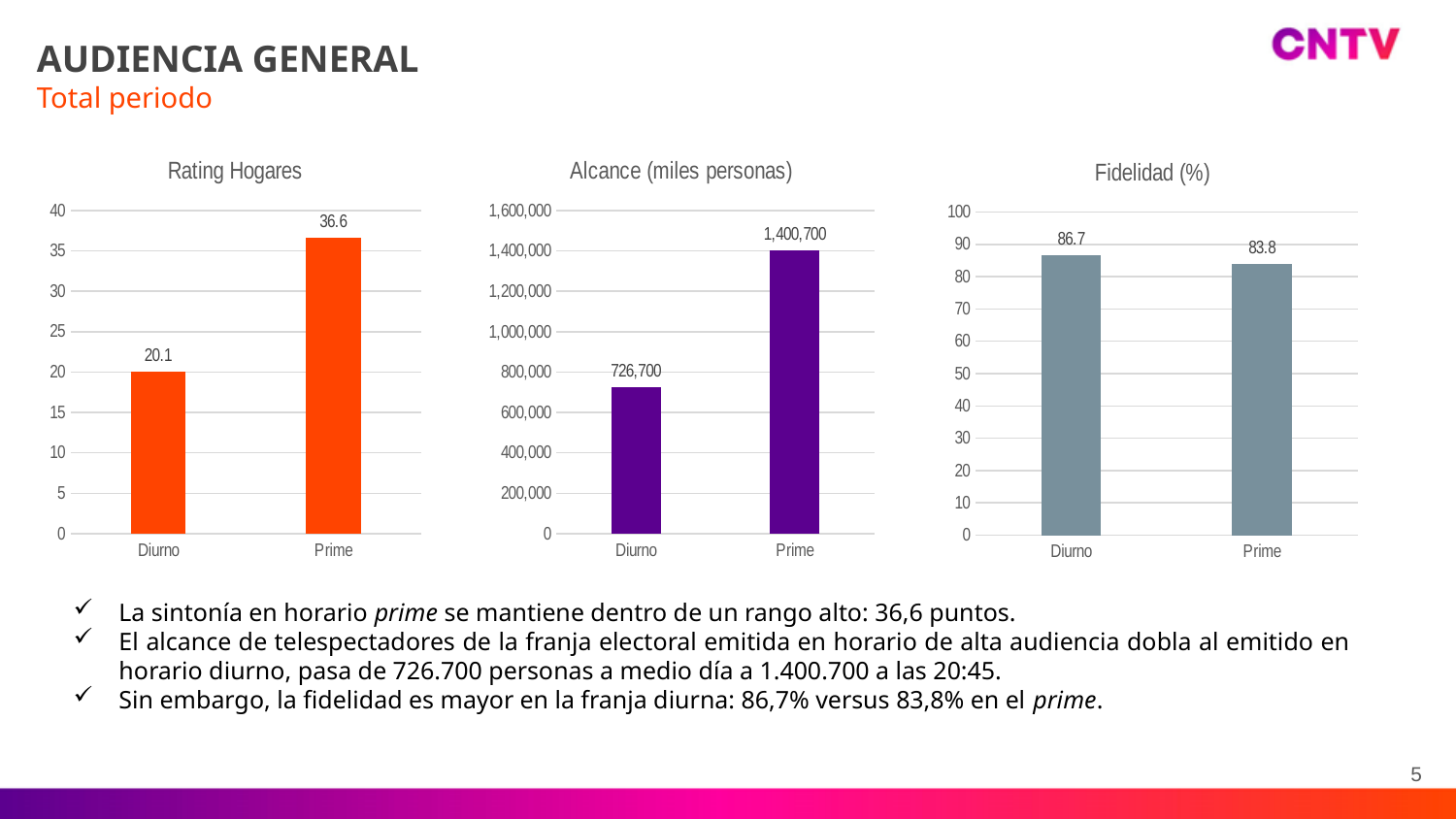
In the 'Rating Hogares' chart, what is the difference between the Prime and Diurno values? 16.5 What kind of chart is the 'Fidelidad (%)' chart? Bar chart In the 'Fidelidad (%)' chart, what is the value for Diurno? 86.7 In the 'Rating Hogares' chart, what is the value for Diurno? 20.1 In the 'Alcance (miles personas)' chart, what is the value for Diurno? 726,700 In the 'Alcance (miles personas)' chart, which category has the highest value? Prime In the 'Rating Hogares' chart, is the value for Diurno greater or less than 20? greater In the 'Alcance (miles personas)' chart, what is the difference between the Prime and Diurno values? 674,000 In the 'Fidelidad (%)' chart, what is the difference between the Diurno and Prime values? 2.9 In the 'Alcance (miles personas)' chart, what is the value for Prime? 1,400,700 In the 'Rating Hogares' chart, what is the value for Prime? 36.6 In the 'Fidelidad (%)' chart, which category has the lowest value? Prime